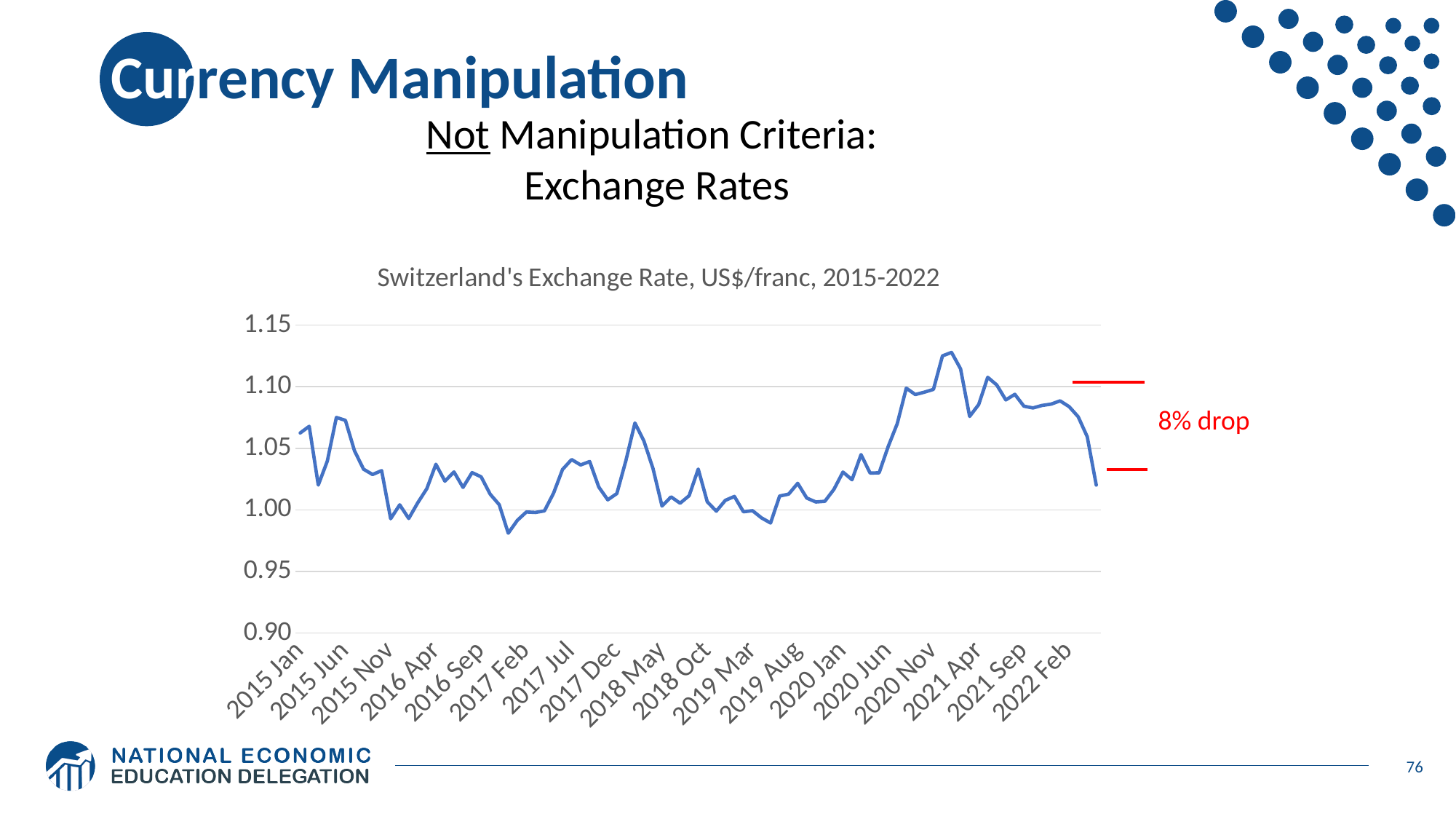
How many date labels are shown on the x axis? 18 What does the red annotation to the right of the line say? 8% drop Does the exchange rate rise or fall between 2019 Aug and 2020 Nov? rise Is the value for 2016 Apr greater or less than 1.00? greater Is the highest point on the line greater or less than 1.10? greater Is the value for 2015 Jan greater or less than 1.05? greater What kind of chart is shown on the slide? Line chart What is the title of the chart? Switzerland's Exchange Rate, US$/franc, 2015-2022